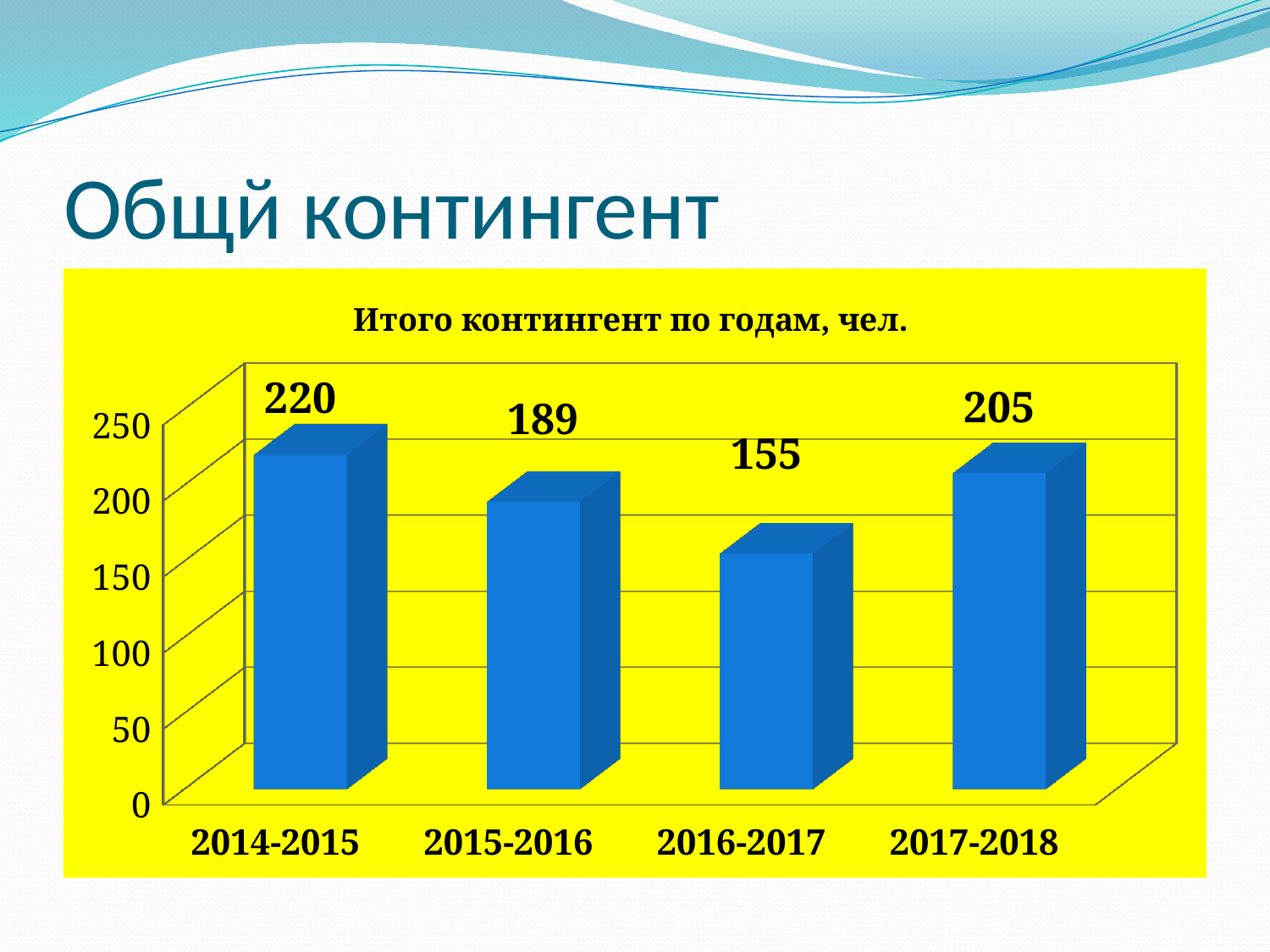
How many years are shown on the chart? 4 Which year has the highest value? 2014-2015 Which year has the lowest value? 2016-2017 What is the value for 2015-2016? 189 What is the difference between the values for 2014-2015 and 2016-2017? 65 Which is larger, the value for 2015-2016 or the value for 2017-2018? 2017-2018 What is the title of the chart? Итого контингент по годам, чел. What kind of chart is shown on the slide? bar chart What is the value for 2016-2017? 155 What is the value for 2014-2015? 220 What is the value for 2017-2018? 205 What is the difference between the values for 2017-2018 and 2015-2016? 16